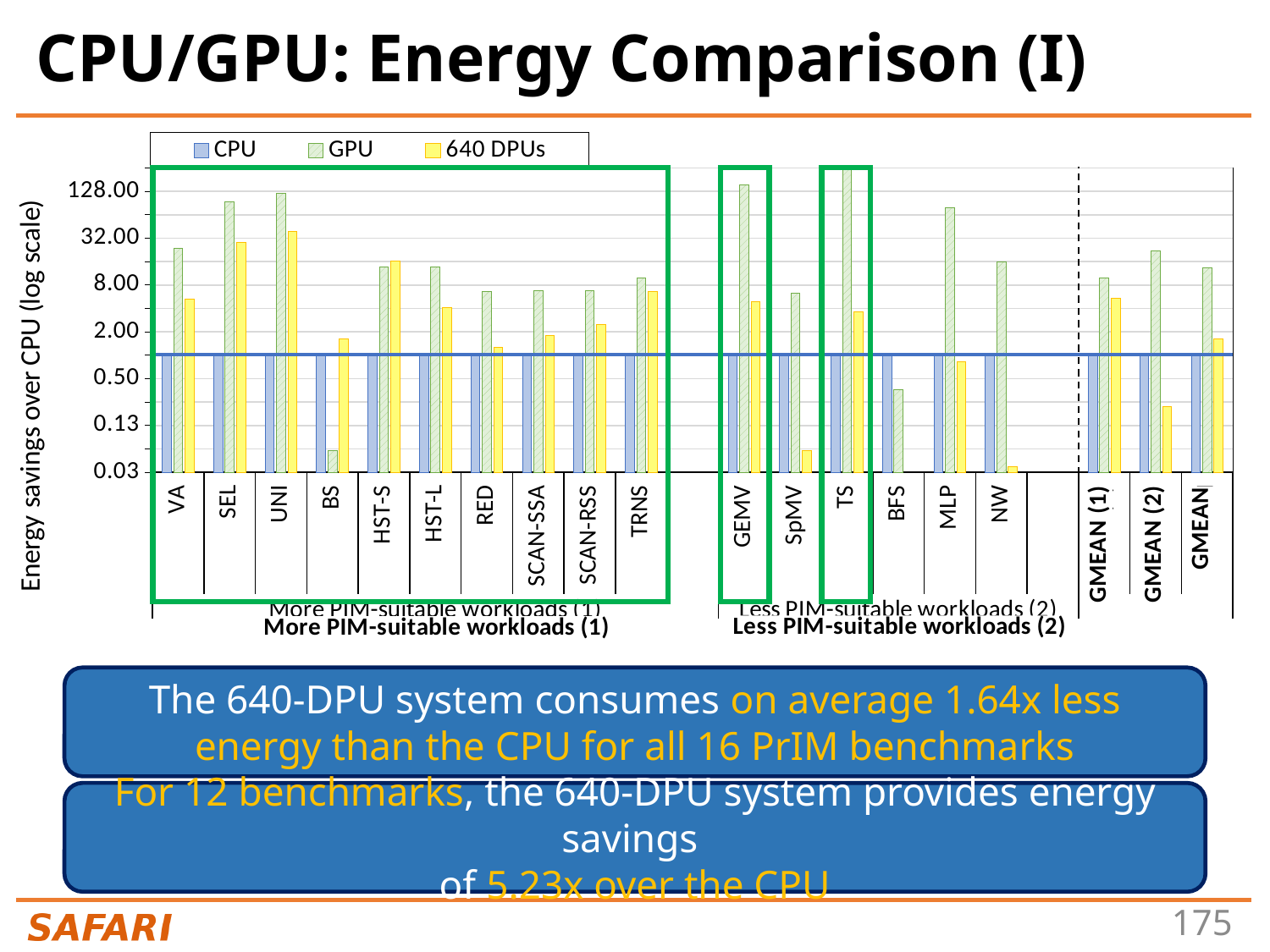
Is the 640 DPUs value for GMEAN (2) greater or less than 0.50? less For BS, which is larger: the GPU value or the 640 DPUs value? 640 DPUs What kind of chart is shown on the slide? bar chart How many series does the legend list? 3 Is the 640 DPUs value for NW greater or less than 0.13? less What is the label of the y axis? Energy savings over CPU (log scale) Is the GPU value for UNI greater or less than 32.00? greater What are the three series listed in the legend? CPU, GPU, 640 DPUs How many categories are shown along the x axis? 19 For SEL, which is larger: the GPU value or the 640 DPUs value? GPU